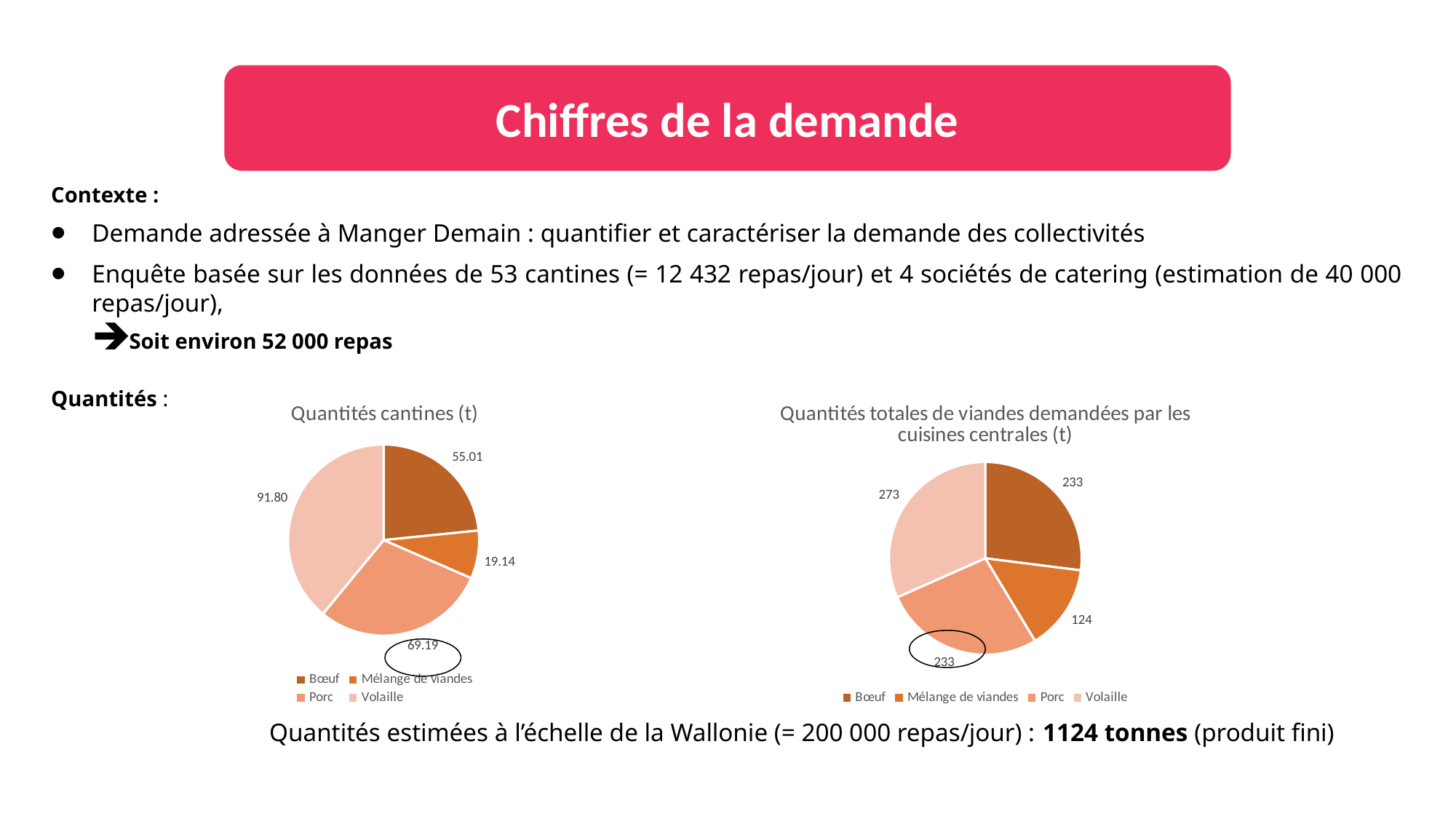
In the 'Quantités totales de viandes demandées par les cuisines centrales (t)' pie chart, what is the value for Mélange de viandes? 124 In the 'Quantités totales de viandes demandées par les cuisines centrales (t)' pie chart, what is the difference between the values for Volaille and Mélange de viandes? 149 In the 'Quantités cantines (t)' pie chart, which category has the smallest value? Mélange de viandes In the 'Quantités cantines (t)' pie chart, what is the value for Mélange de viandes? 19.14 In the 'Quantités cantines (t)' pie chart, which category has the largest value? Volaille In the 'Quantités totales de viandes demandées par les cuisines centrales (t)' pie chart, which category has the smallest value? Mélange de viandes How many categories does the 'Quantités cantines (t)' pie chart show? 4 In the 'Quantités cantines (t)' pie chart, what is the difference between the values for Porc and Bœuf? 14.18 In the 'Quantités totales de viandes demandées par les cuisines centrales (t)' pie chart, what is the value for Volaille? 273 What type of chart is used for 'Quantités totales de viandes demandées par les cuisines centrales (t)'? Pie chart In the 'Quantités cantines (t)' pie chart, which is larger, Porc or Bœuf? Porc In the 'Quantités cantines (t)' pie chart, what is the value for Volaille? 91.80